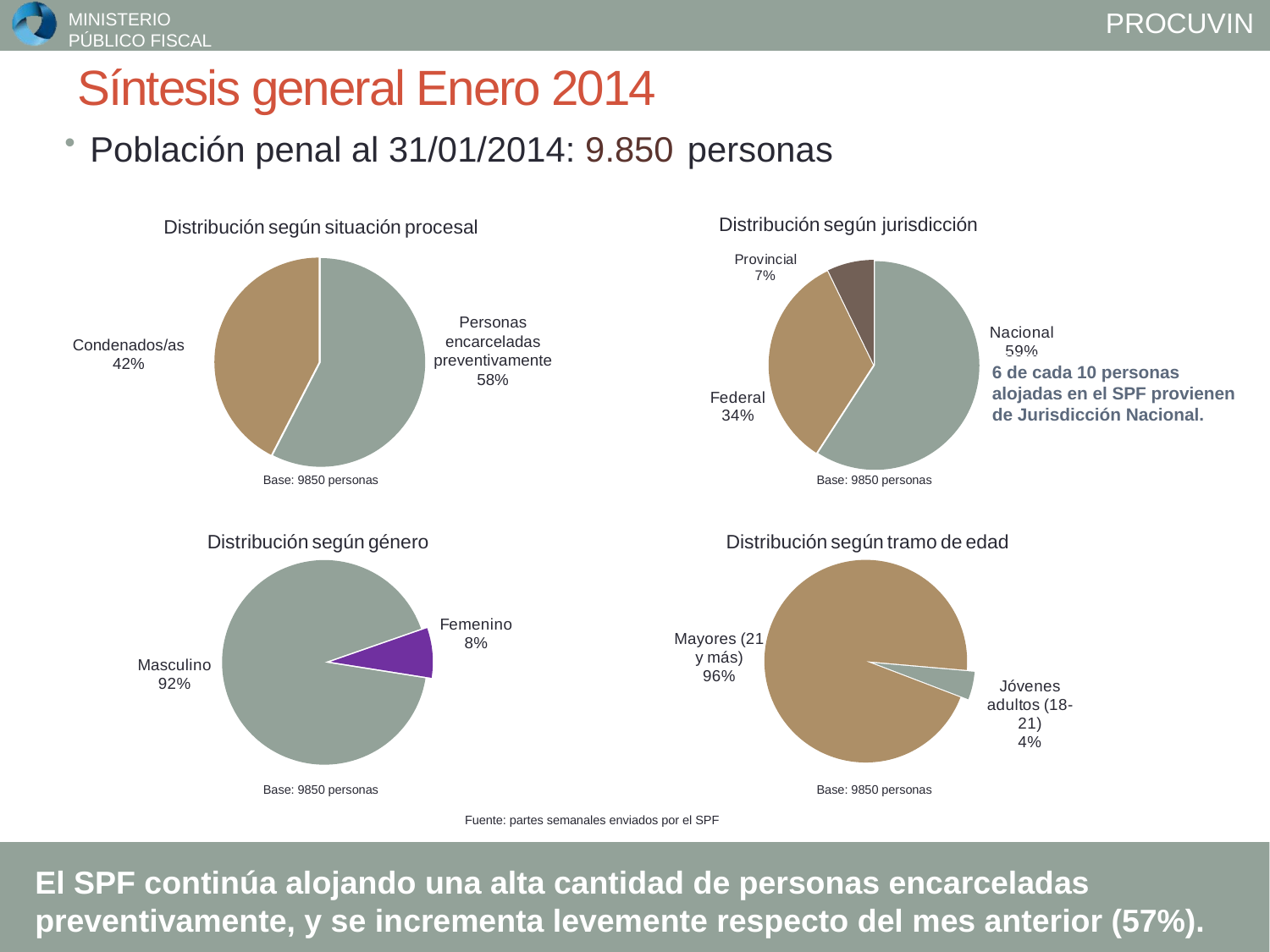
In the 'Distribución según género' chart, what is the value for Femenino? 8% In the 'Distribución según tramo de edad' chart, what is the difference between Mayores (21 y más) and Jóvenes adultos (18-21)? 92% In the 'Distribución según situación procesal' chart, what share is labelled for Condenados/as? 42% In the 'Distribución según tramo de edad' chart, what share is labelled for Jóvenes adultos (18-21)? 4% In the 'Distribución según género' chart, which is larger, Masculino or Femenino? Masculino In the 'Distribución según jurisdicción' chart, which category has the smallest slice? Provincial In the 'Distribución según jurisdicción' chart, what is the difference between the Nacional and Federal shares? 25% What type of chart is the 'Distribución según género' chart? Pie chart How many categories are shown in the 'Distribución según jurisdicción' chart? 3 In the 'Distribución según jurisdicción' chart, which category has the largest slice? Nacional In the 'Distribución según situación procesal' chart, what is the value for Personas encarceladas preventivamente? 58% In the 'Distribución según jurisdicción' chart, what is the value for Federal? 34%